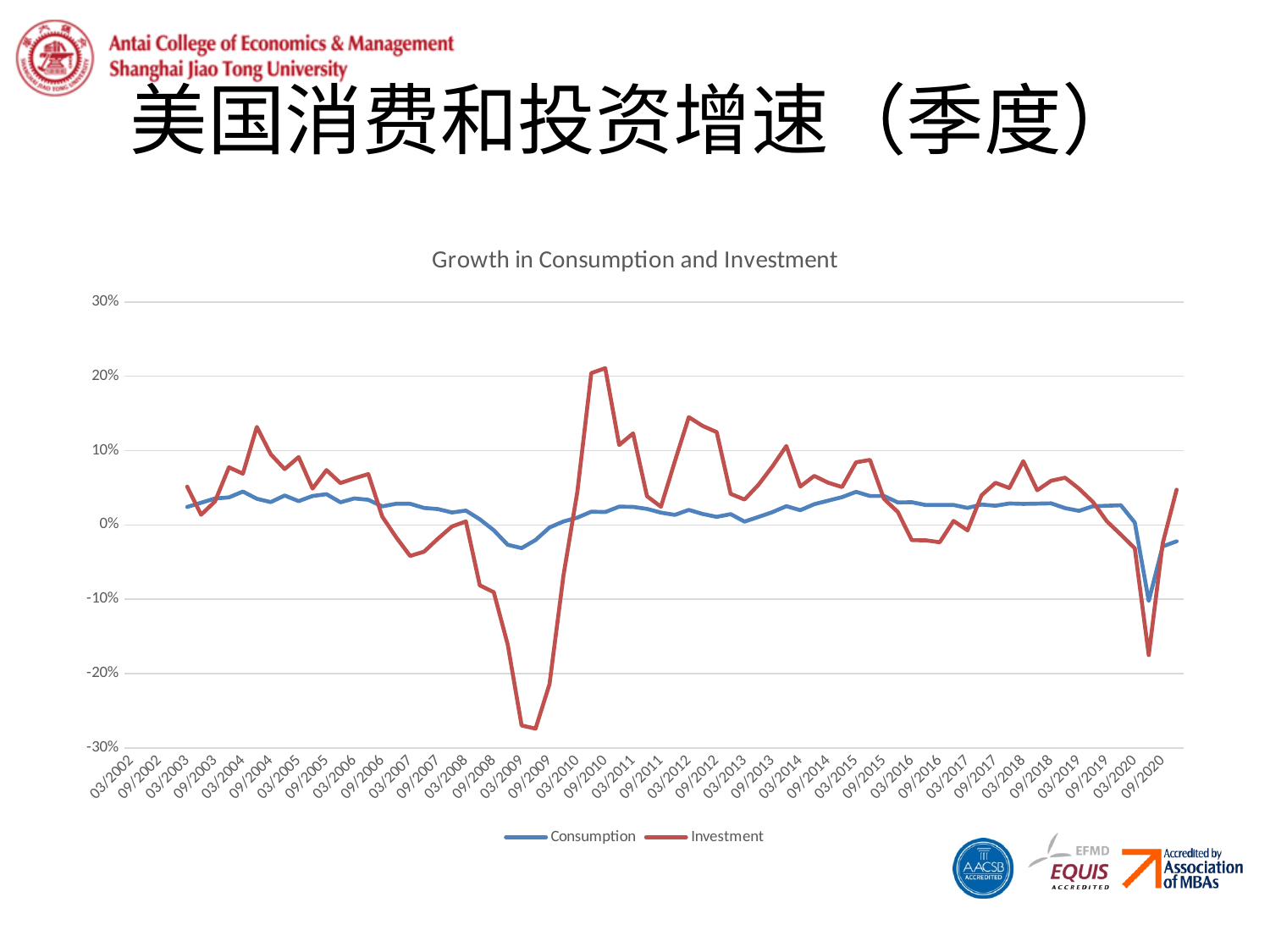
Which colour is used for the Investment line? Red What kind of chart is shown on the slide? Line chart How many series does the chart's legend list? 2 Does the Consumption line rise or fall between 03/2008 and 03/2009? Fall Around 09/2009, which series has the lower value, Consumption or Investment? Investment What is the title printed above the chart? Growth in Consumption and Investment Does the Investment line rise or fall between 09/2009 and 03/2010? Rise Is the Investment value around 09/2009 greater or less than -20%? less Is the Investment value around 09/2010 greater or less than 10%? greater Which series reaches the lowest point anywhere on the chart? Investment